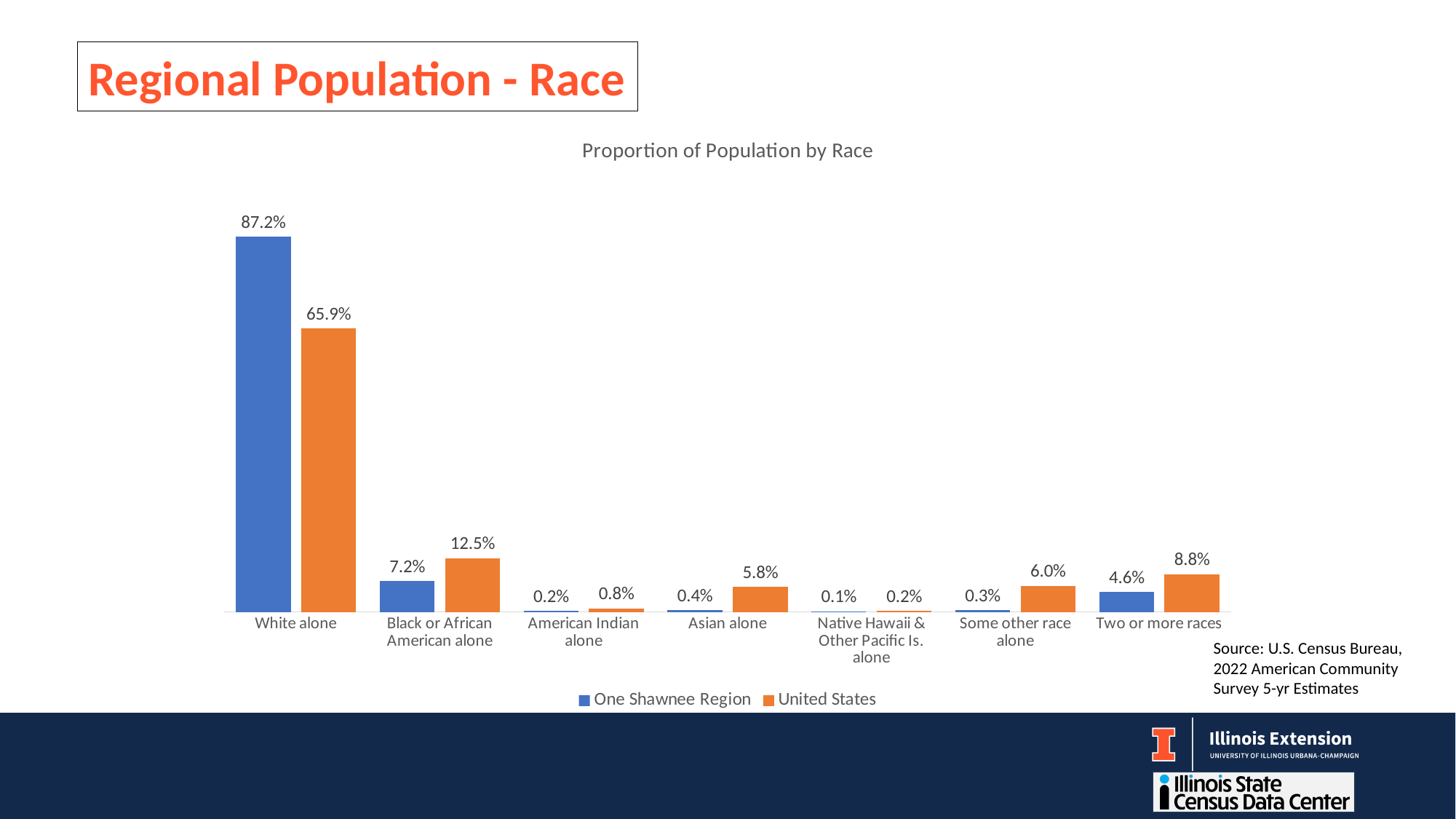
What is the One Shawnee Region value for White alone? 87.2% How many race categories are shown on the x axis? 7 What is the United States value for Black or African American alone? 12.5% Which category has the highest United States value? White alone Which category has the lowest One Shawnee Region value? Native Hawaii & Other Pacific Is. alone What is the difference between the One Shawnee Region and United States values for White alone? 21.3% What is the One Shawnee Region value for Asian alone? 0.4% Which is larger for Some other race alone: the One Shawnee Region value or the United States value? United States How many series does the legend list? 2 What kind of chart is shown on the slide? Bar chart What is the United States value for Two or more races? 8.8% What is the title of the chart? Proportion of Population by Race